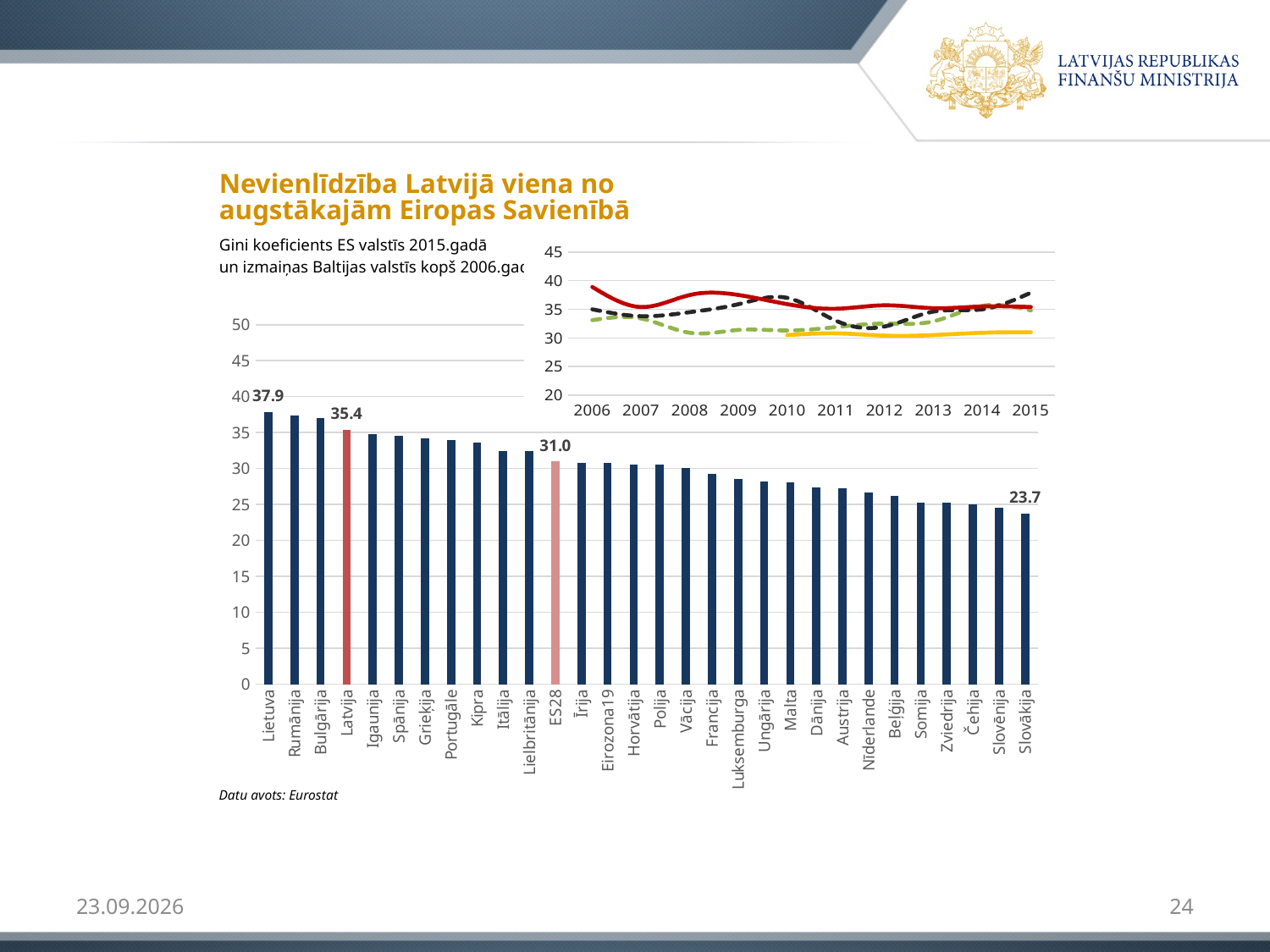
In the line chart at the top right, how many years are shown on the x axis? 10 In the bar chart, which country has the highest Gini coefficient? Lietuva In the bar chart, what is the value shown for Slovākija? 23.7 In the bar chart, what is the value shown for Latvija? 35.4 What kind of chart is the large chart at the bottom of the slide? Bar chart In the bar chart, what is the value shown for ES28? 31.0 In the bar chart, what is the difference between the values for Lietuva and Latvija? 2.5 In the bar chart, what is the Gini coefficient value shown for Lietuva? 37.9 In the bar chart, how much higher is Latvija's value than the ES28 value? 4.4 In the bar chart, which country has the lowest Gini coefficient? Slovākija In the bar chart, how many bars (countries and aggregates) are shown? 30 In the bar chart, is the value for Rumānija greater or less than 35? greater